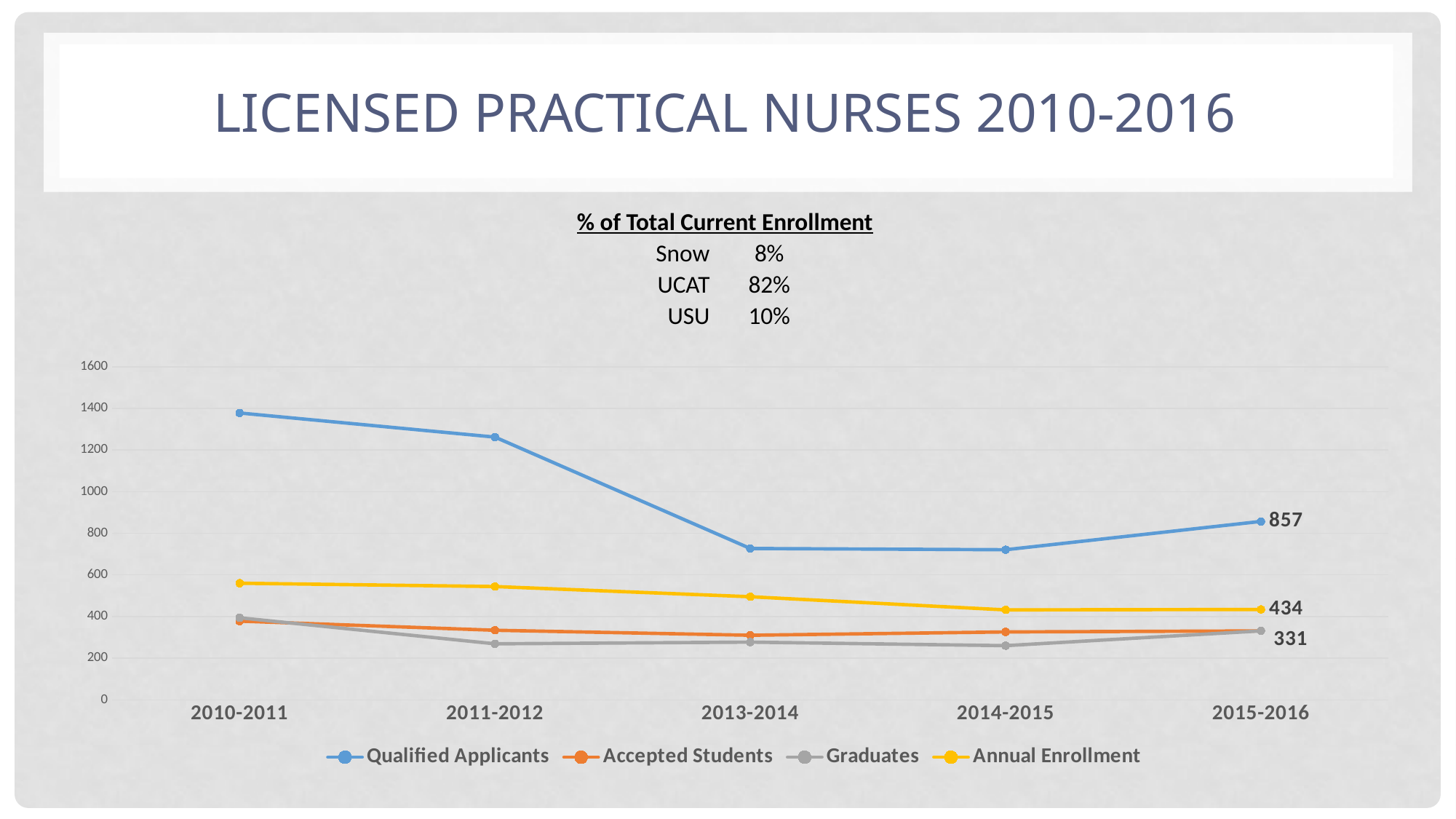
Is the value for Annual Enrollment in 2010-2011 greater or less than 400? greater What is the value for Qualified Applicants in 2015-2016? 857 Is the value for Qualified Applicants in 2013-2014 greater or less than 800? less Is the value for Qualified Applicants in 2010-2011 greater or less than 1200? greater What is the difference between Qualified Applicants and Annual Enrollment in 2015-2016? 423 Which is larger for Qualified Applicants: the value in 2011-2012 or the value in 2013-2014? 2011-2012 How many series does the chart legend list? 4 Does the Annual Enrollment line rise or fall from 2010-2011 to 2015-2016? fall What kind of chart is shown on the slide? line chart What is the value for Annual Enrollment in 2015-2016? 434 Which series has the highest value in 2010-2011? Qualified Applicants How many academic years are shown on the x axis of the chart? 5